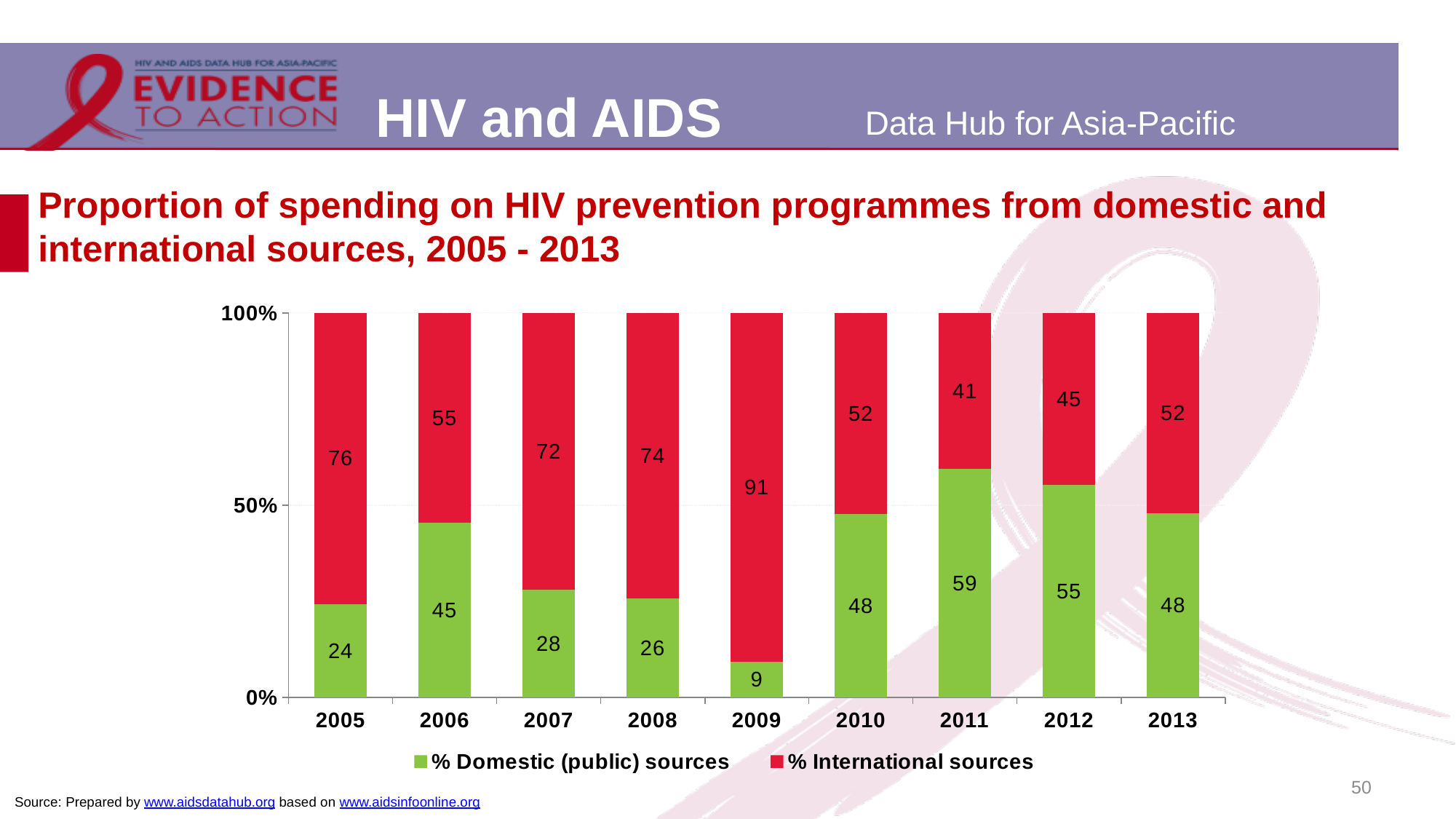
Which is larger, the % Domestic (public) sources value for 2006 or for 2007? 2006 Which year has the lowest value for % Domestic (public) sources? 2009 How many series does the legend list? 2 What is the value for % Domestic (public) sources in 2009? 9 What is the total of the stacked bar for 2012? 100 Which colour represents % International sources in the legend? Red What is the value for % International sources in 2005? 76 How many years are shown on the x axis? 9 Which year has the highest value for % International sources? 2009 What is the difference between the % International sources values for 2005 and 2013? 24 What kind of chart is shown on the slide? Stacked bar chart What is the value for % Domestic (public) sources in 2011? 59